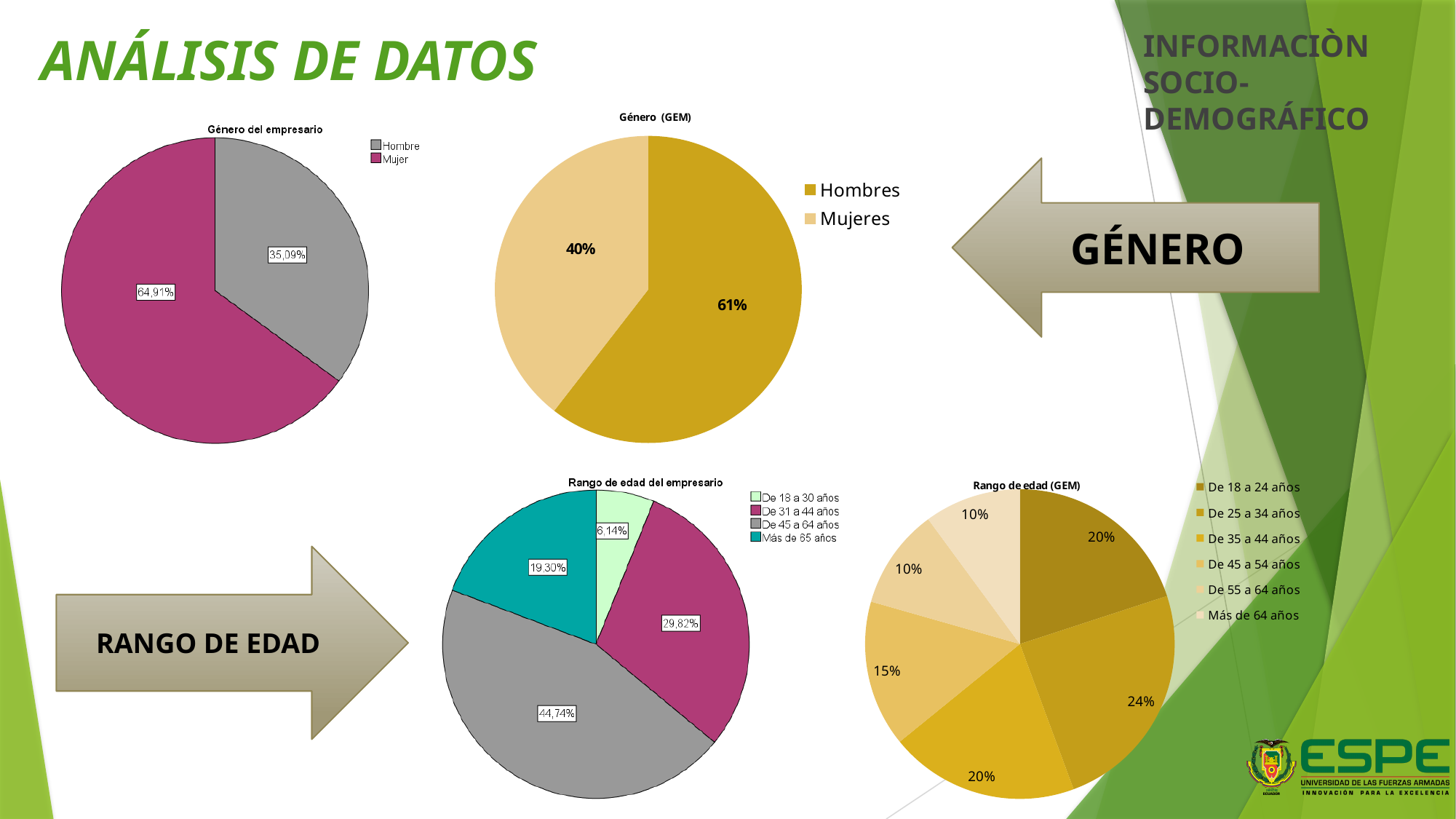
In the 'Género (GEM)' pie chart, what percentage is shown for Mujeres? 40% In the 'Género del empresario' pie chart, what percentage is shown for Mujer? 64,91% In the 'Rango de edad del empresario' pie chart, what is the difference between the shares for 'De 31 a 44 años' and 'Más de 65 años'? 10,52% What type of chart is 'Género del empresario'? Pie chart In the 'Rango de edad (GEM)' pie chart, what percentage is shown for 'De 25 a 34 años'? 24% In the 'Género del empresario' pie chart, what percentage is shown for Hombre? 35,09% In the 'Género (GEM)' pie chart, what percentage is shown for Hombres? 61% In the 'Género (GEM)' pie chart, which category has the larger share, Hombres or Mujeres? Hombres In the 'Rango de edad del empresario' pie chart, which age range has the smallest share? De 18 a 30 años How many categories does the legend of the 'Rango de edad (GEM)' chart list? 6 In the 'Rango de edad del empresario' pie chart, what percentage is shown for 'De 45 a 64 años'? 44,74% How many categories does the 'Rango de edad del empresario' pie chart have? 4